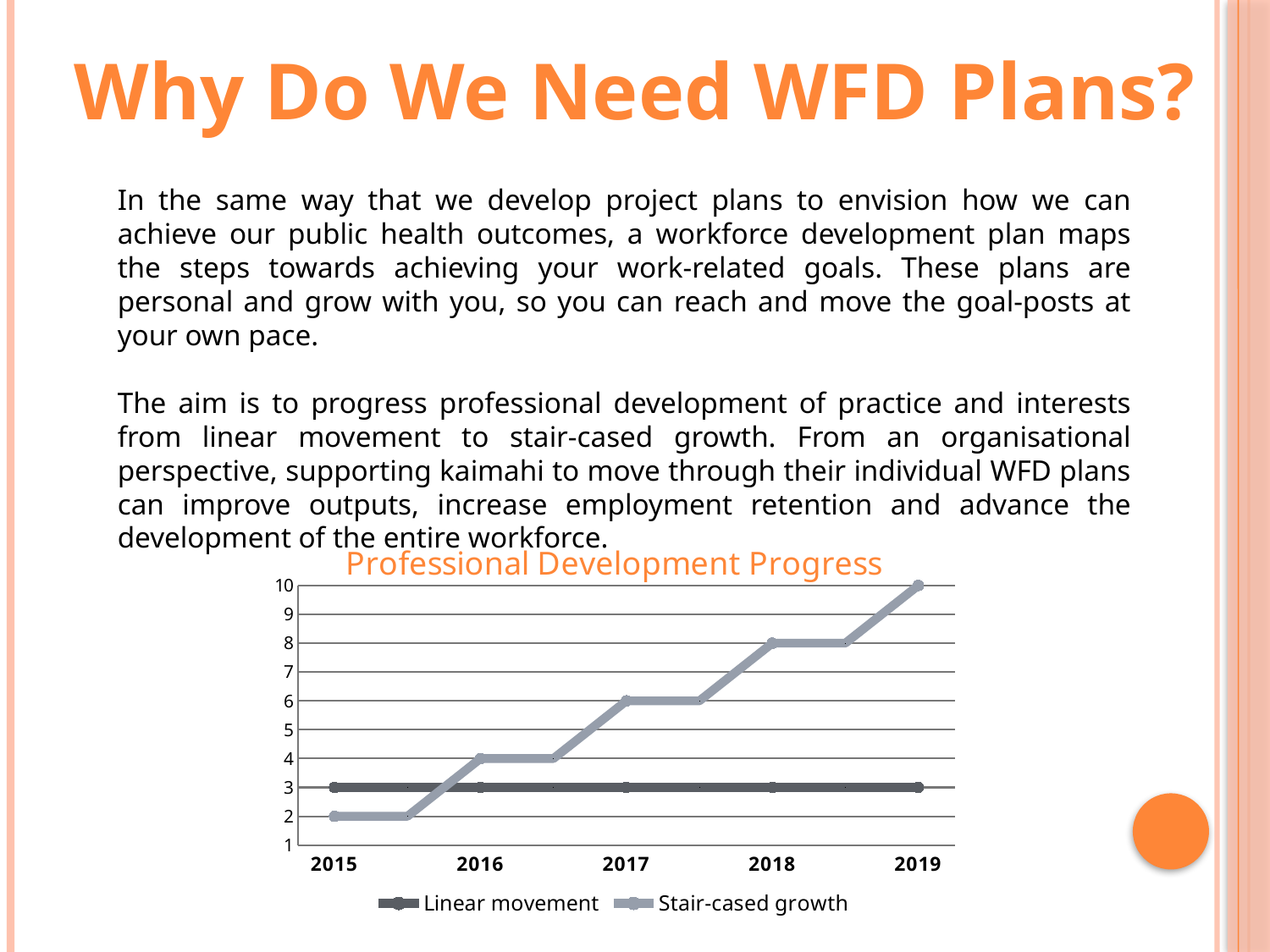
How many year labels are shown on the x axis of the chart? 5 What is the difference between the Stair-cased growth value in 2019 and its value in 2015? 8 What is the value of the Linear movement series in 2017? 3 In 2018, which series has the larger value, Linear movement or Stair-cased growth? Stair-cased growth Does the Stair-cased growth series rise or fall from 2015 to 2019? Rise What is the value of the Stair-cased growth series in 2019? 10 In which year does the Stair-cased growth series reach its highest value? 2019 What is the value of the Stair-cased growth series in 2017? 6 How many series does the legend of the "Professional Development Progress" chart list? 2 What is the value of the Stair-cased growth series in 2015? 2 In which year is the Stair-cased growth series at its lowest value? 2015 What kind of chart is shown under the title "Professional Development Progress"? Line chart